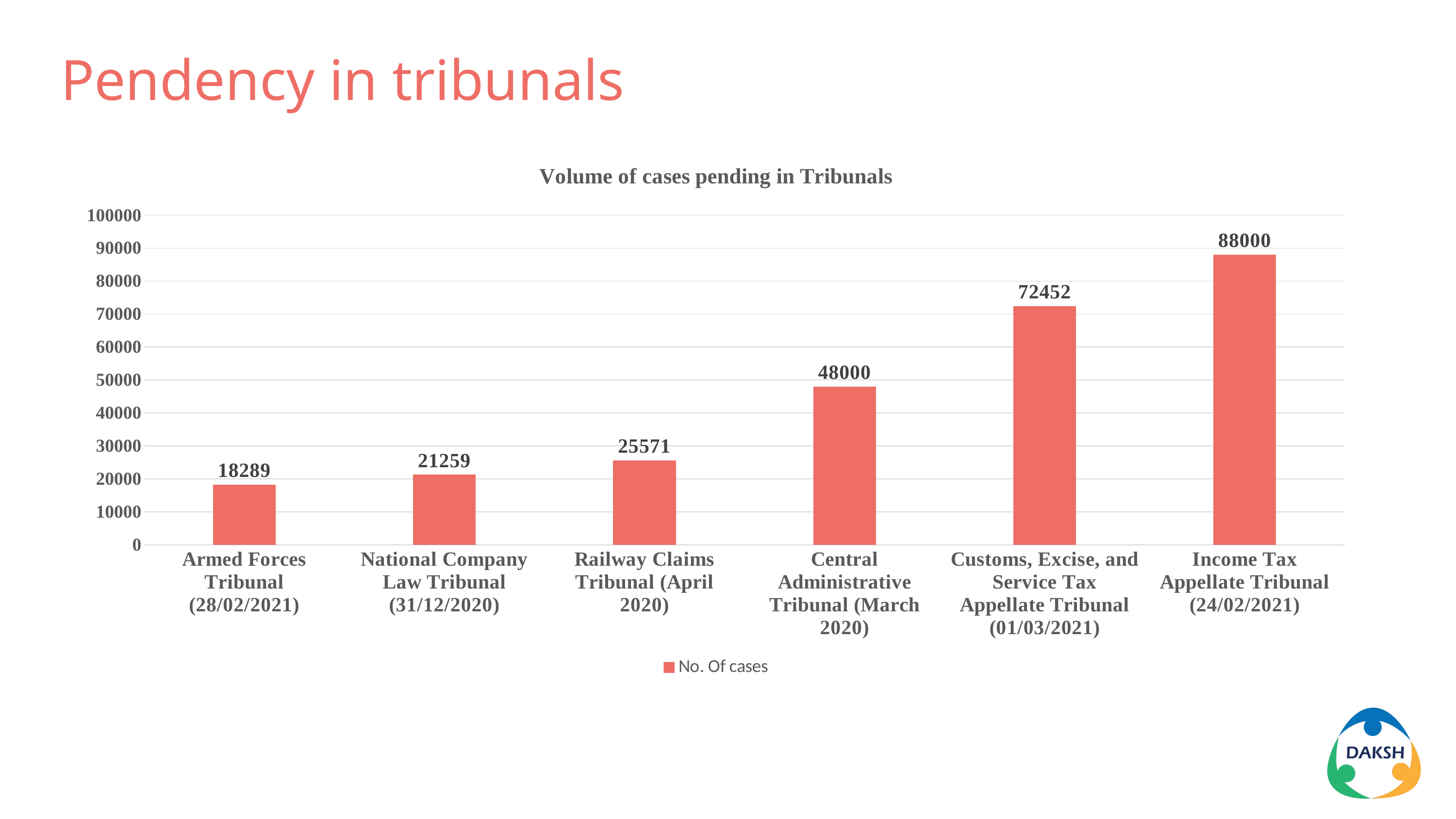
What is the number of cases pending in the Armed Forces Tribunal (28/02/2021)? 18289 What is the difference in pending cases between the Railway Claims Tribunal and the National Company Law Tribunal? 4312 How many tribunals are shown in the chart? 6 What is the title of the chart? Volume of cases pending in Tribunals What type of chart is shown on the slide? Bar chart What is the number of cases pending in the Central Administrative Tribunal (March 2020)? 48000 What is the number of cases pending in the Customs, Excise, and Service Tax Appellate Tribunal (01/03/2021)? 72452 What is the difference in pending cases between the Income Tax Appellate Tribunal and the Central Administrative Tribunal? 40000 Is the value for the Customs, Excise, and Service Tax Appellate Tribunal greater or less than 70000? greater Which has more pending cases, the Railway Claims Tribunal or the National Company Law Tribunal? Railway Claims Tribunal Which tribunal has the highest number of pending cases? Income Tax Appellate Tribunal (24/02/2021) Which tribunal has the lowest number of pending cases? Armed Forces Tribunal (28/02/2021)